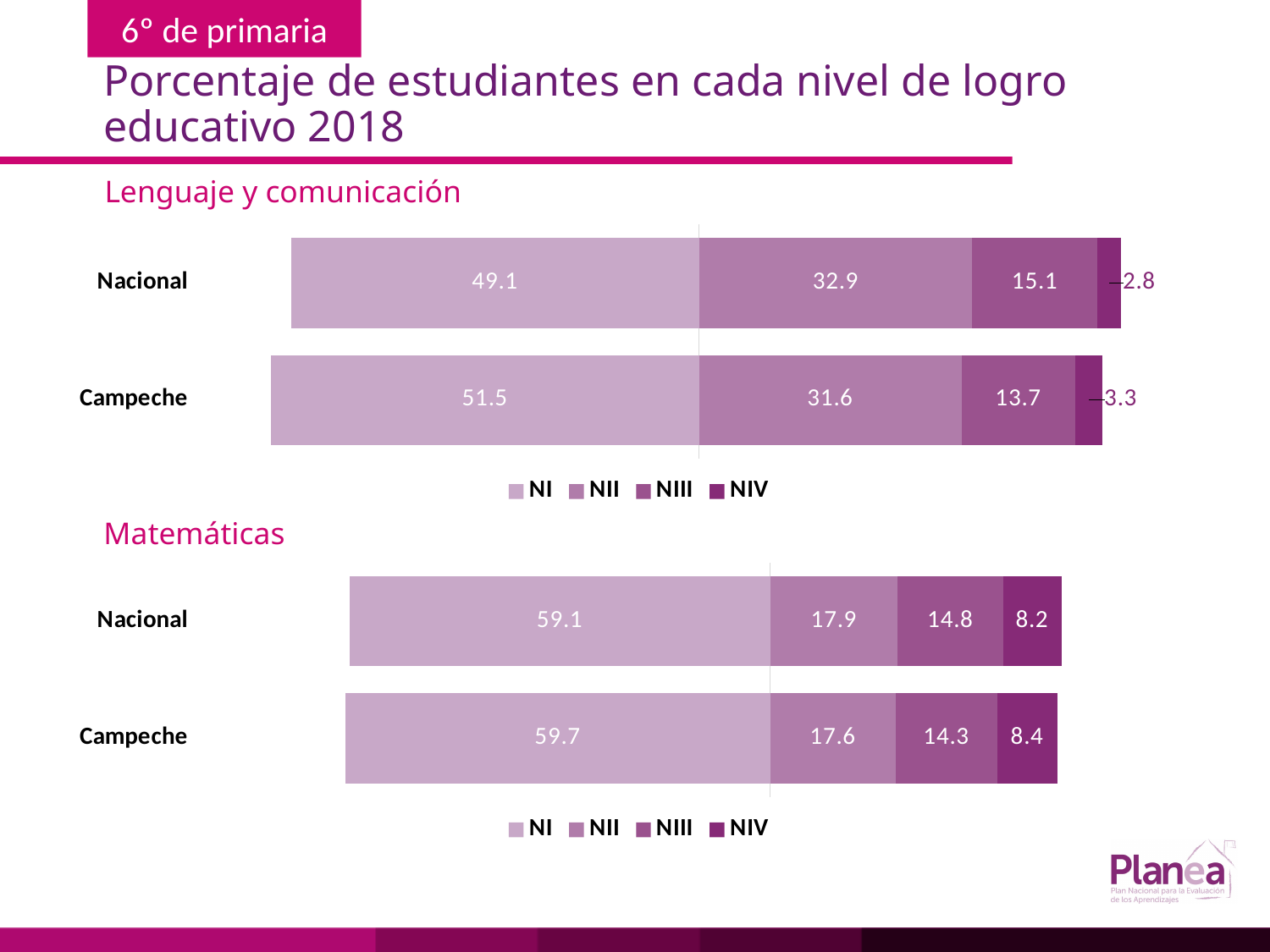
In the Lenguaje y comunicación chart, what is the difference between the NI values for Campeche and Nacional? 2.4 In the Lenguaje y comunicación chart, what is the NI value for Nacional? 49.1 How many series does the legend of the Matemáticas chart list? 4 In the Matemáticas chart, what is the NIII value for Nacional? 14.8 In the Lenguaje y comunicación chart, which is larger, the NIII value for Nacional or for Campeche? Nacional How many categories are shown in the Lenguaje y comunicación chart? 2 What kind of chart is the Matemáticas chart? Stacked bar chart In the Matemáticas chart, what is the NII value for Campeche? 17.6 In the Lenguaje y comunicación chart, which level has the highest value for Nacional? NI In the Matemáticas chart, which level has the lowest value for Campeche? NIV In the Matemáticas chart, what is the total of the stacked bar for Nacional? 100.0 In the Lenguaje y comunicación chart, what is the NIV value for Campeche? 3.3